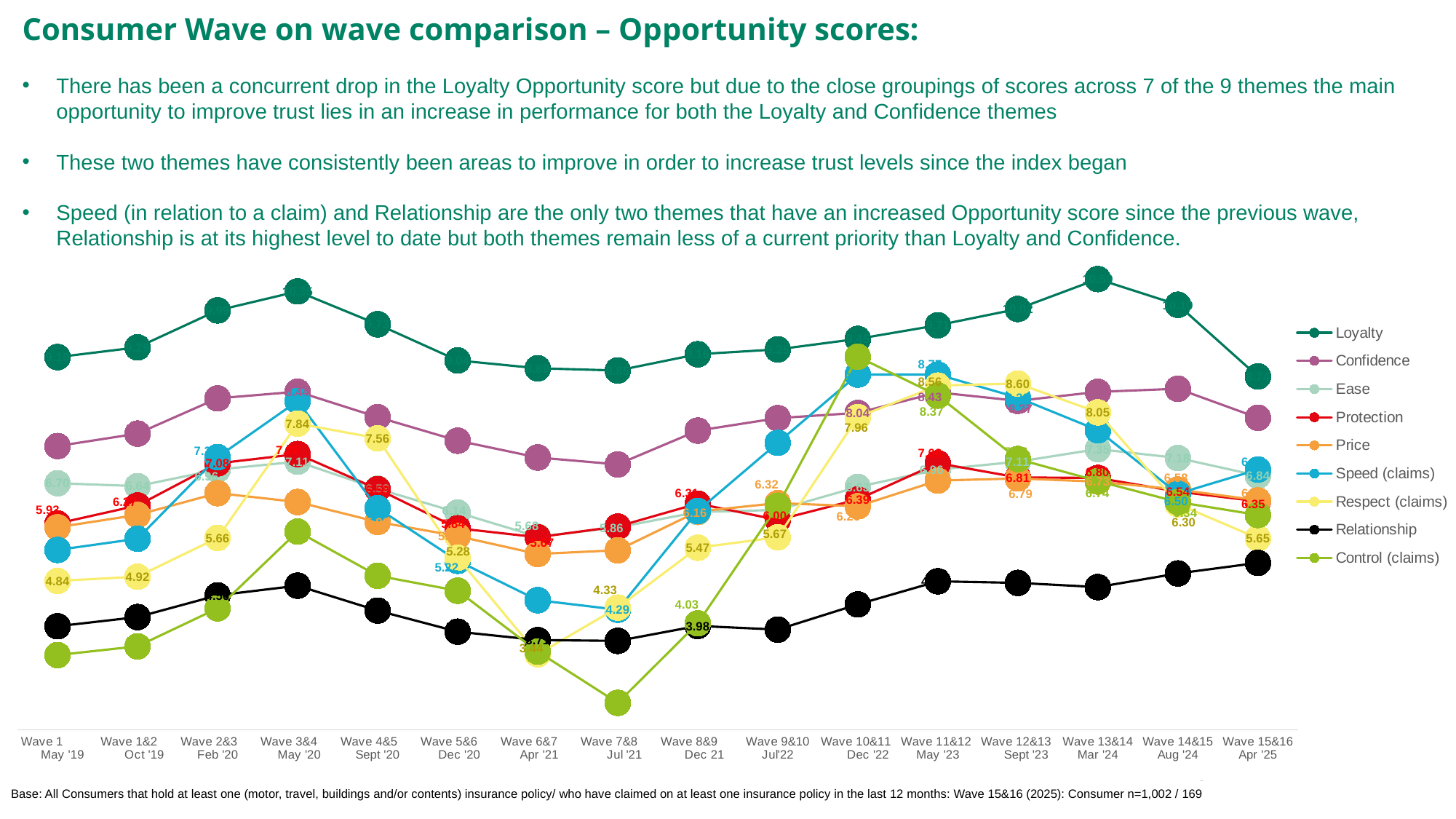
What is the Protection score at Wave 1 May '19? 5.93 What kind of chart is shown on the slide? line chart What is the Respect (claims) score at Wave 1 May '19? 4.84 Which series has the highest score at every wave? Loyalty How many waves are plotted along the x axis? 16 What is the Respect (claims) score at Wave 3&4 May '20? 7.84 How many series does the legend list? 9 What is the Relationship score at Wave 8&9 Dec 21? 3.98 What is the Speed (claims) score at Wave 15&16 Apr '25? 6.96 Which series has the lowest score at Wave 7&8 Jul '21? Control (claims) At Wave 15&16 Apr '25, which is higher: Loyalty or Confidence? Loyalty What is the difference between the Respect (claims) scores at Wave 3&4 May '20 and Wave 4&5 Sept '20? 0.28